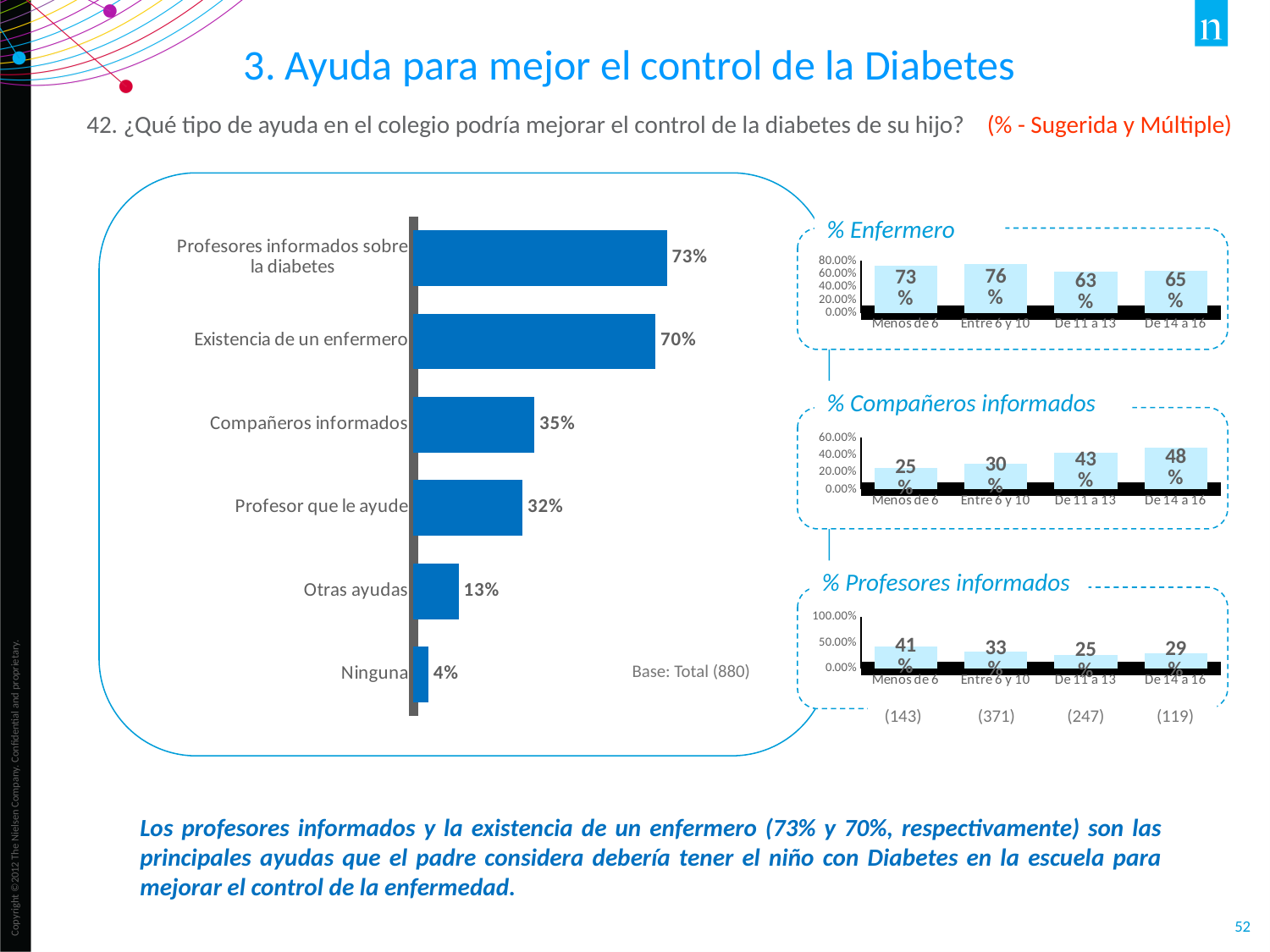
In the '% Enfermero' chart, what is the value for 'Entre 6 y 10'? 76% In the '% Profesores informados' chart, which is larger: 'Menos de 6' or 'De 11 a 13'? Menos de 6 In the main bar chart on the left, which category has the highest value? Profesores informados sobre la diabetes In the '% Profesores informados' chart, what is the value for 'De 14 a 16'? 29% In the main bar chart on the left, which category has the lowest value? Ninguna In the main bar chart on the left, how many categories are shown? 6 In the main bar chart on the left, what is the difference between 'Compañeros informados' and 'Profesor que le ayude'? 3% In the '% Compañeros informados' chart, what is the difference between 'De 14 a 16' and 'Menos de 6'? 23% In the '% Enfermero' chart, which age group has the lowest value? De 11 a 13 In the main bar chart on the left, what is the value for 'Existencia de un enfermero'? 70% In the '% Compañeros informados' chart, do the values rise or fall from 'Menos de 6' to 'De 14 a 16'? Rise What type of chart is the main chart on the left? Bar chart